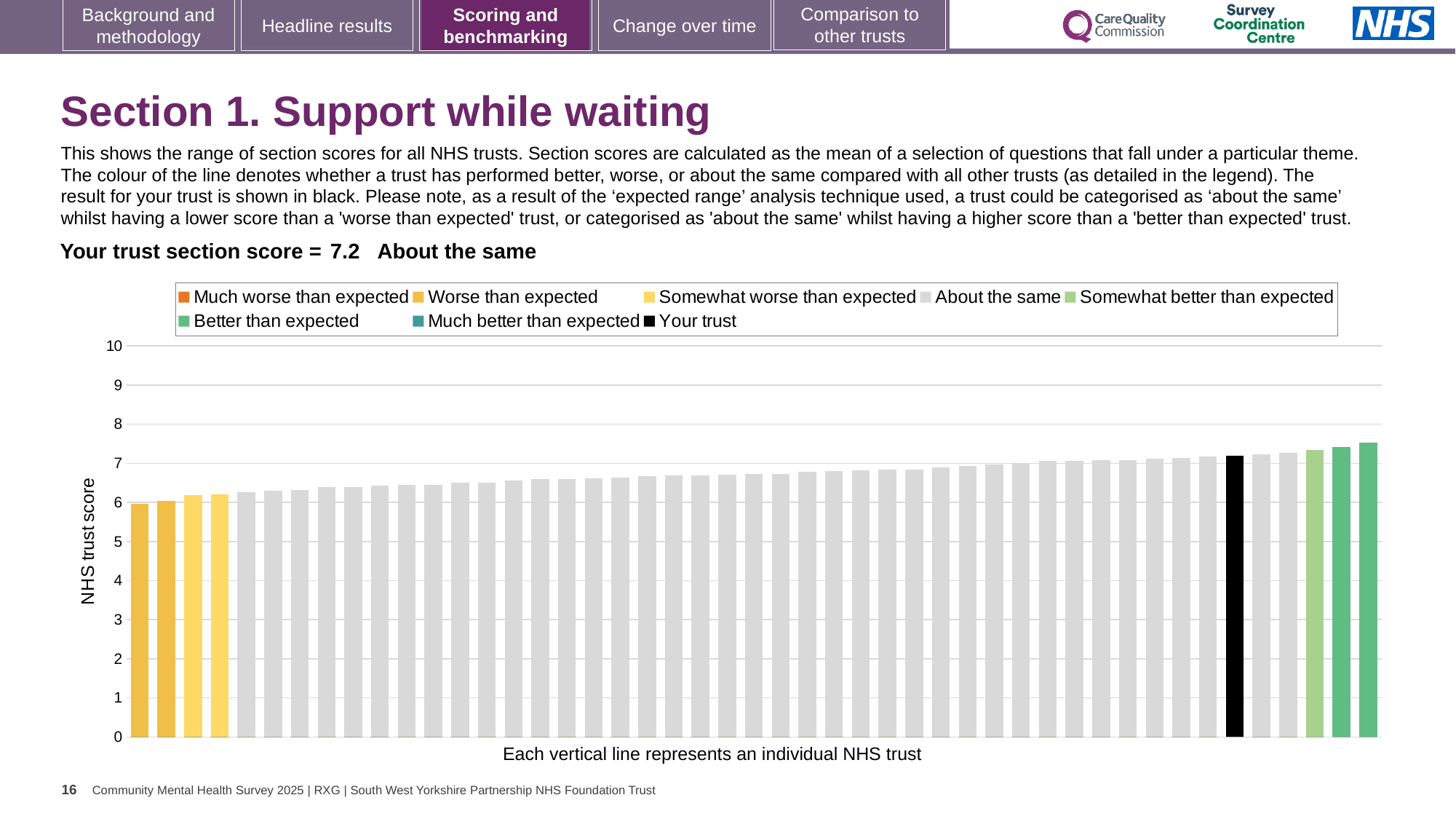
What is the label on the y axis of the chart? NHS trust score What kind of chart is shown on the slide? bar chart What is the section score for your trust? 7.2 Is the bar for your trust taller or shorter than the tallest bar on the chart? shorter Is the value for your trust (the black bar) greater or less than 7? greater Which category is your trust placed in for this section? About the same Do the bar values rise or fall from left to right along the x axis? rise How many bars are coloured as 'Better than expected' (green)? 2 Is the value of the tallest bar greater or less than 7? greater How many entries does the chart legend list? 8 Is the value of the shortest bar greater or less than 7? less How many bars are coloured as 'Worse than expected' (dark yellow)? 2